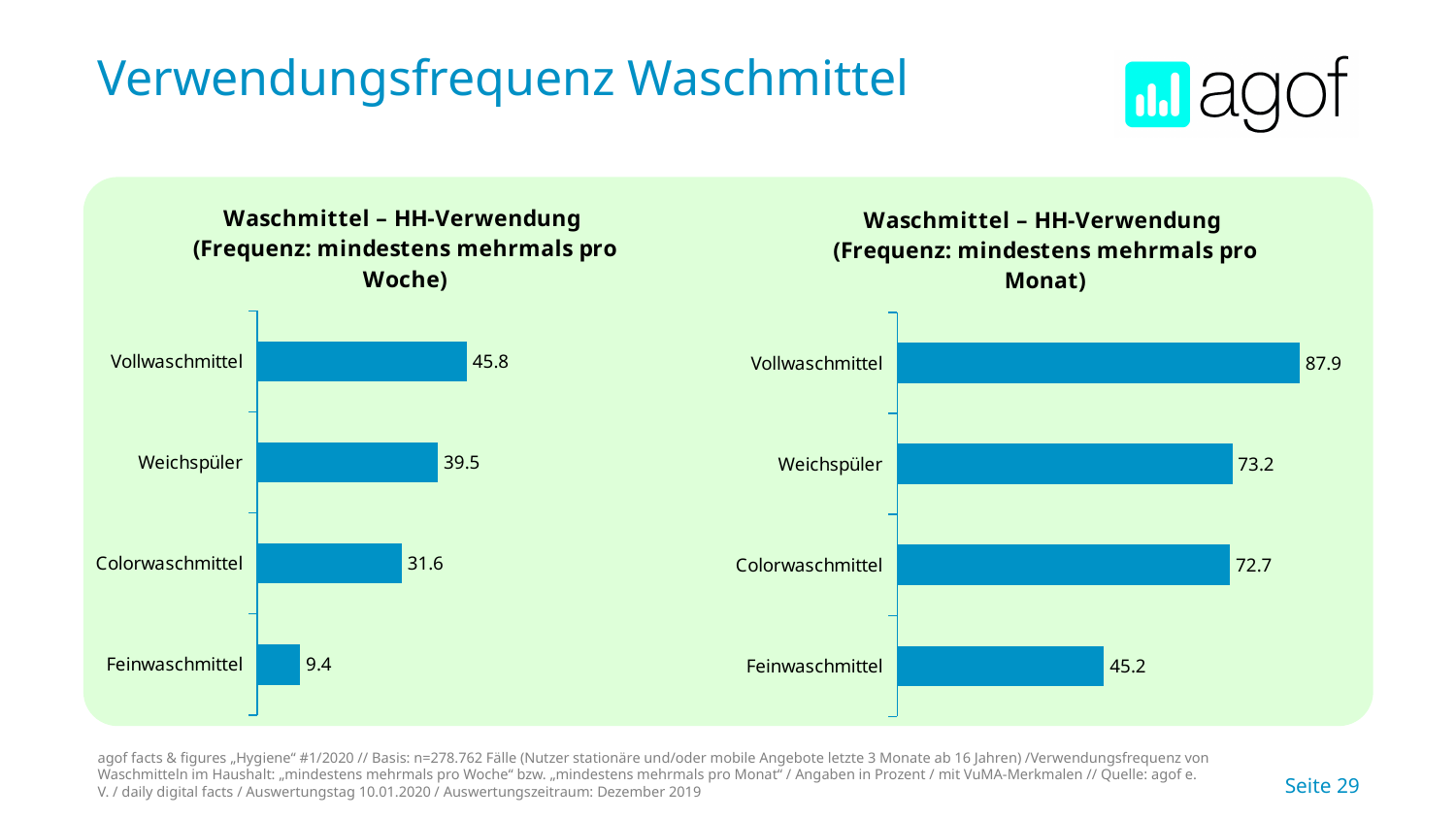
In the right chart (Frequenz: mindestens mehrmals pro Monat), which category has the highest value? Vollwaschmittel In the left chart (Frequenz: mindestens mehrmals pro Woche), which category has the lowest value? Feinwaschmittel In the left chart (Frequenz: mindestens mehrmals pro Woche), what is the value for Vollwaschmittel? 45.8 In the left chart (Frequenz: mindestens mehrmals pro Woche), which is larger: Weichspüler or Colorwaschmittel? Weichspüler In the right chart (Frequenz: mindestens mehrmals pro Monat), what is the value for Feinwaschmittel? 45.2 In the right chart (Frequenz: mindestens mehrmals pro Monat), what is the value for Weichspüler? 73.2 In the right chart (Frequenz: mindestens mehrmals pro Monat), what is the difference between Vollwaschmittel and Feinwaschmittel? 42.7 In the left chart (Frequenz: mindestens mehrmals pro Woche), what is the value for Colorwaschmittel? 31.6 What type of chart is the right chart (Frequenz: mindestens mehrmals pro Monat)? Bar chart How many categories are shown in the left chart (Frequenz: mindestens mehrmals pro Woche)? 4 What is the title of the right chart? Waschmittel – HH-Verwendung (Frequenz: mindestens mehrmals pro Monat) In the left chart (Frequenz: mindestens mehrmals pro Woche), what is the difference between Vollwaschmittel and Weichspüler? 6.3